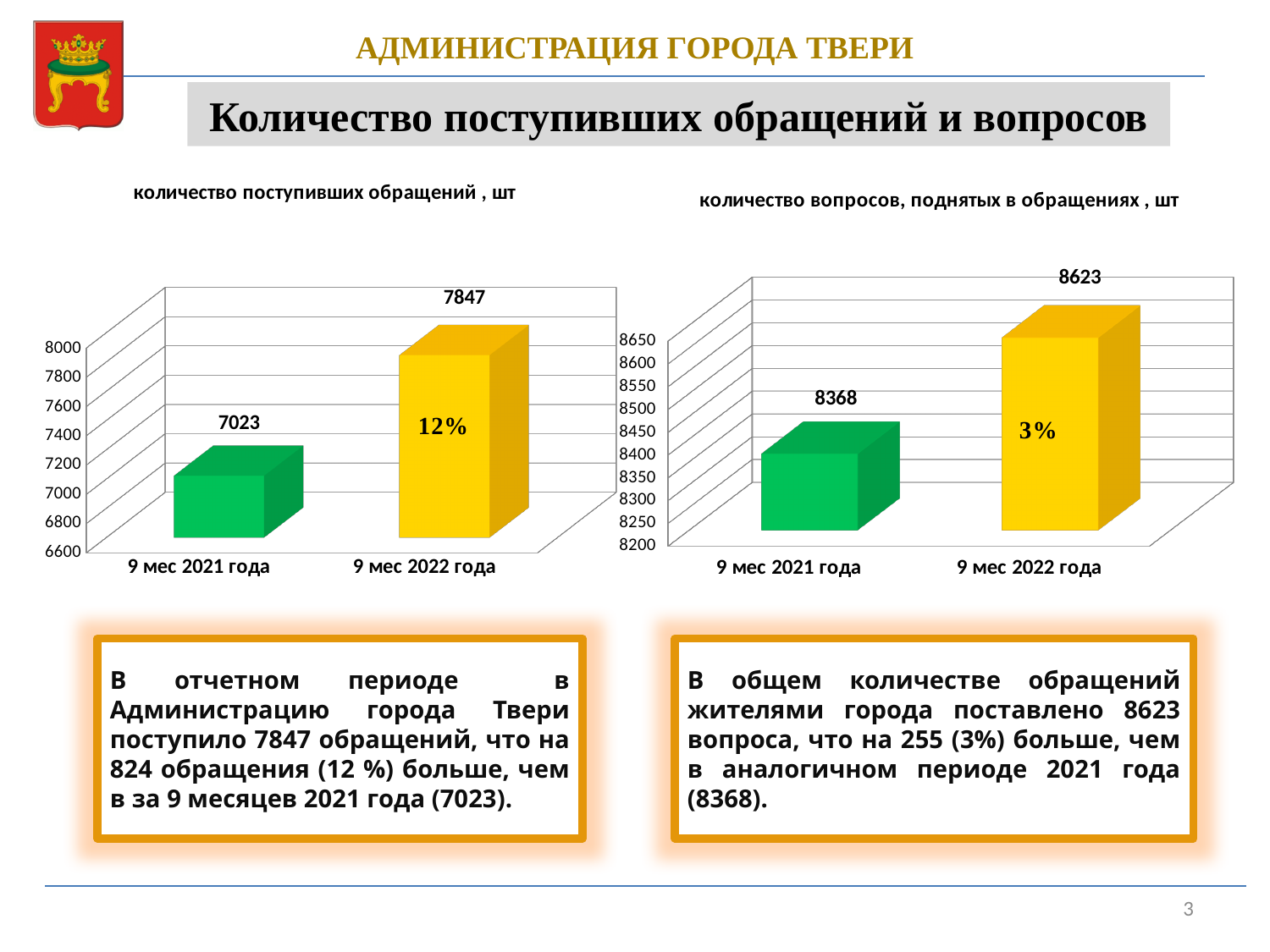
In the right chart (количество вопросов, поднятых в обращениях, шт), what is the value for 9 мес 2021 года? 8368 In the right chart (количество вопросов, поднятых в обращениях, шт), what is the difference between the values for 9 мес 2022 года and 9 мес 2021 года? 255 In the right chart (количество вопросов, поднятых в обращениях, шт), which period has the lower value? 9 мес 2021 года In the right chart (количество вопросов, поднятых в обращениях, шт), is the value for 9 мес 2021 года greater or less than 8400? less In the left chart (количество поступивших обращений, шт), what is the difference between the values for 9 мес 2022 года and 9 мес 2021 года? 824 How many categories are shown on the x axis of the left chart (количество поступивших обращений, шт)? 2 In the left chart (количество поступивших обращений, шт), what is the value for 9 мес 2022 года? 7847 In the left chart (количество поступивших обращений, шт), which period has the higher value? 9 мес 2022 года In the right chart (количество вопросов, поднятых в обращениях, шт), what is the value for 9 мес 2022 года? 8623 What kind of chart is the right chart (количество вопросов, поднятых в обращениях, шт)? bar chart In the left chart (количество поступивших обращений, шт), what is the value for 9 мес 2021 года? 7023 What percentage label is printed on the 9 мес 2022 года bar in the left chart (количество поступивших обращений, шт)? 12%